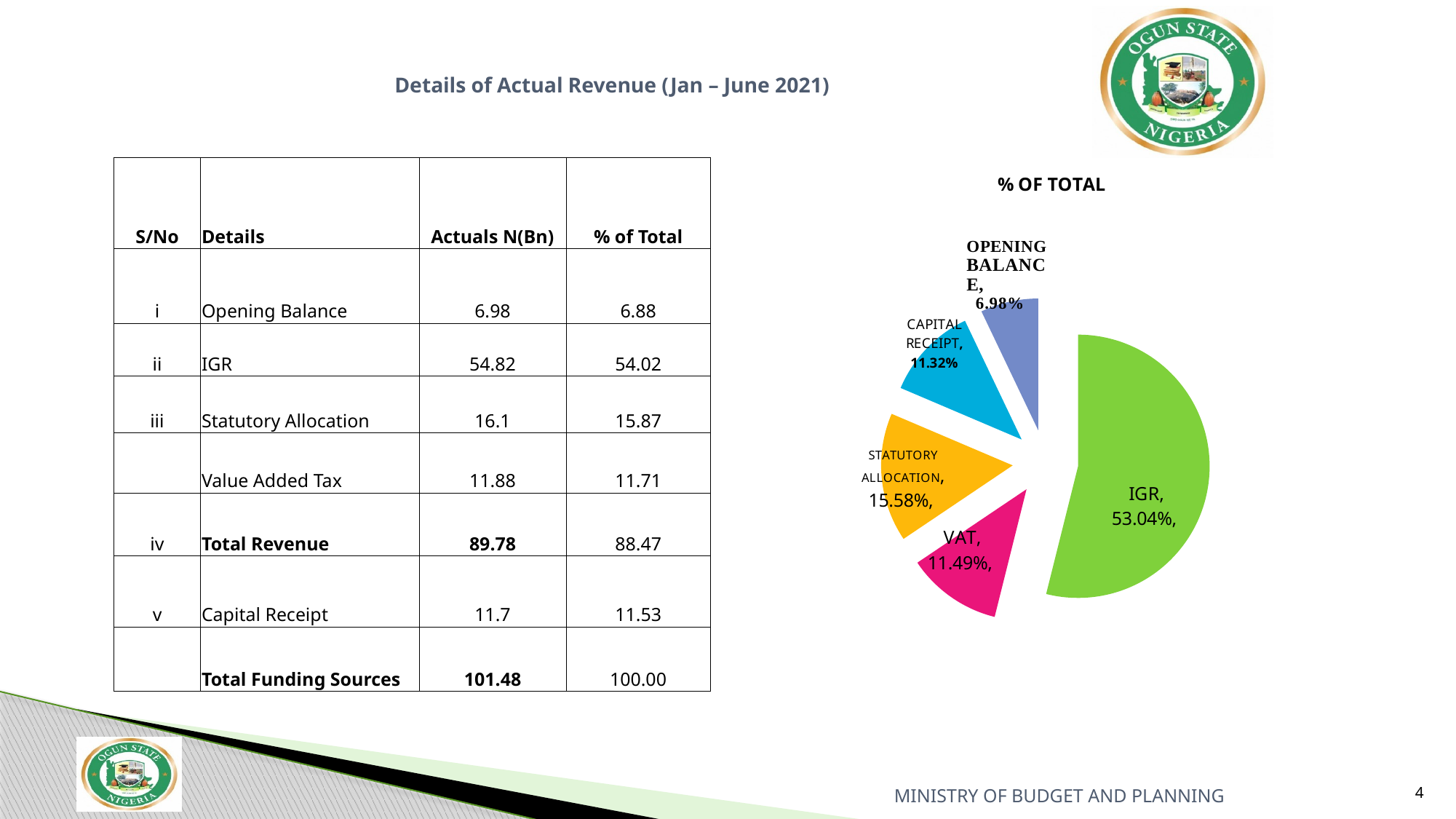
In the pie chart, which is larger: the Statutory Allocation slice or the VAT slice? Statutory Allocation Which slice of the pie chart is the largest? IGR In the pie chart, what share is labelled for Opening Balance? 6.98% How many slices does the pie chart have? 5 In the pie chart, what is the difference between the IGR share and the Statutory Allocation share? 37.46% Which slice of the pie chart is the smallest? Opening Balance What is the title of the pie chart? % OF TOTAL In the pie chart, what share is labelled for Statutory Allocation? 15.58% In the pie chart, what share is labelled for VAT? 11.49% In the pie chart, what share is labelled for IGR? 53.04% What type of chart is shown on the slide? Pie chart In the pie chart, what share is labelled for Capital Receipt? 11.32%